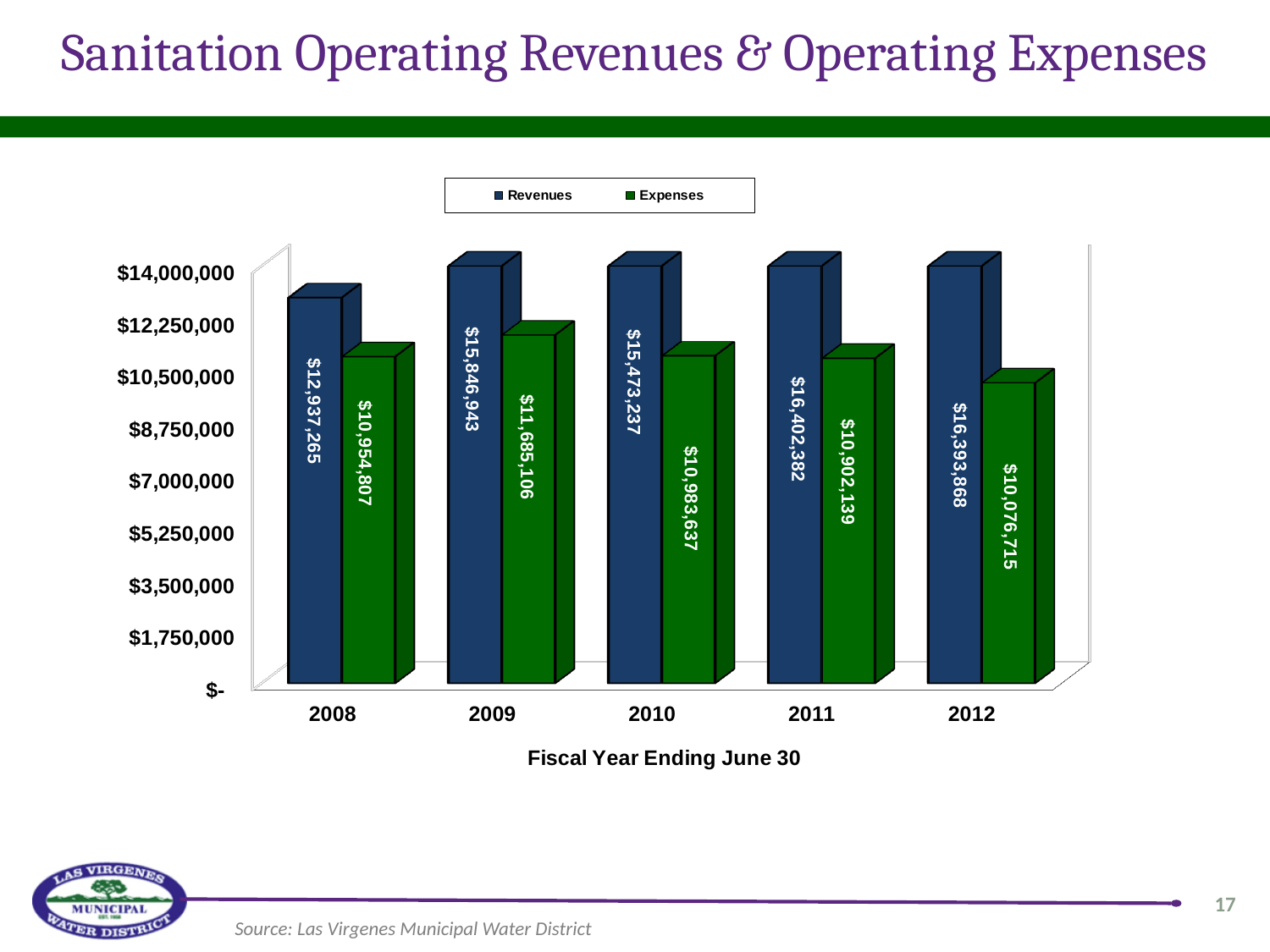
In which fiscal year were Revenues lowest? 2008 What were the Expenses in 2009? $11,685,106 What were the Revenues in 2011? $16,402,382 In which fiscal year were Expenses lowest? 2012 What were the Expenses in 2012? $10,076,715 What kind of chart is shown on the slide? Bar chart In which fiscal year were Expenses highest? 2009 Which was larger in 2010, Revenues or Expenses? Revenues What is the difference between Revenues and Expenses in 2012? $6,317,153 Is the value for Expenses in 2012 greater or less than $10,500,000? less What were the Revenues in 2008? $12,937,265 How many series does the legend list? 2